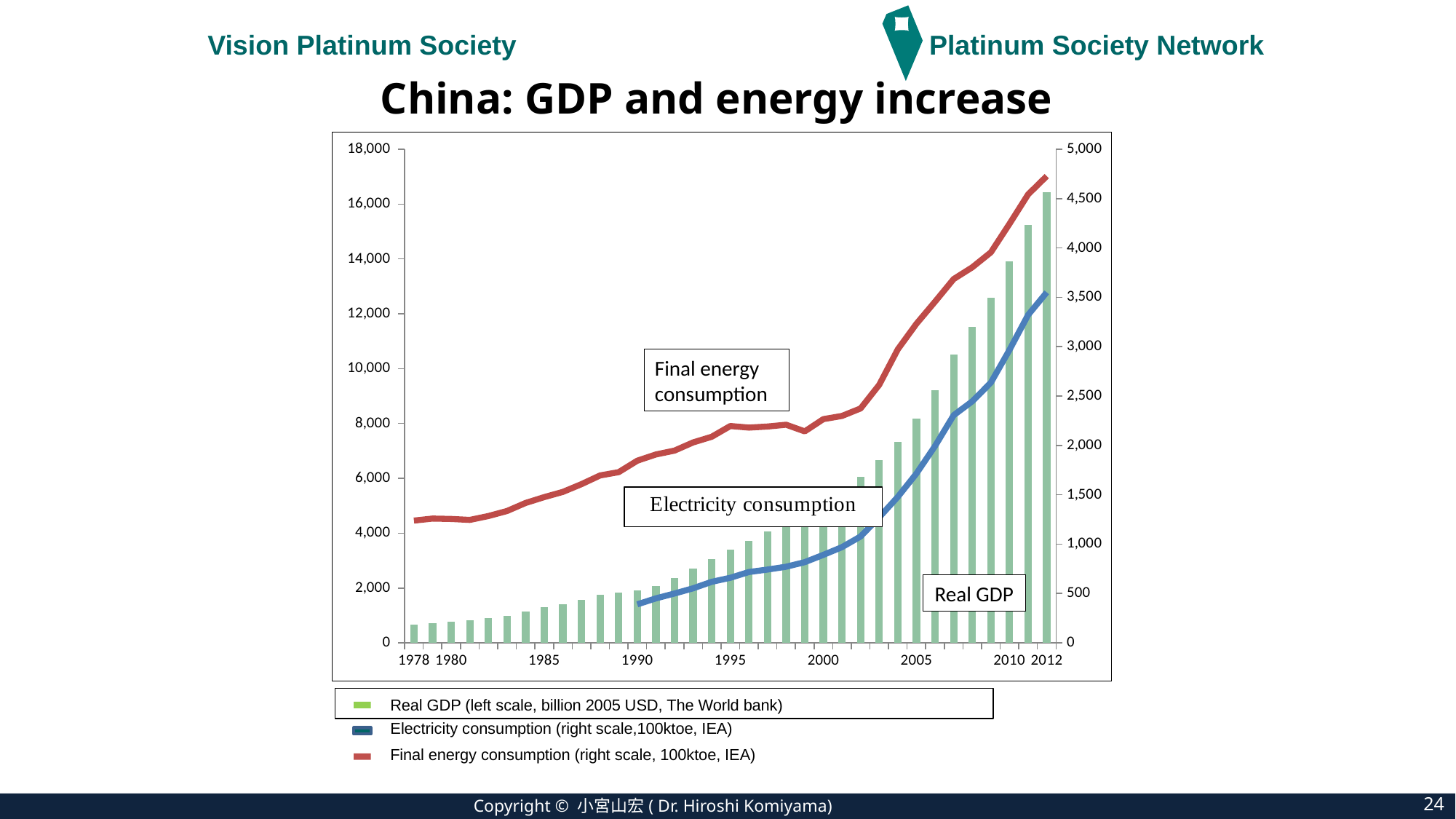
In which year is Real GDP lowest? 1978 Which series is plotted as bars? Real GDP In which year is Real GDP highest? 2012 Is the Real GDP value for 1978 greater or less than 2,000 on the left scale? less What is the title of the chart? China: GDP and energy increase What kind of chart is shown on the slide? A combined bar and line chart Is the Electricity consumption value for 2000 greater or less than 1,000 on the right scale? less In 2012, which is larger on the right scale: Final energy consumption or Electricity consumption? Final energy consumption Does Real GDP rise or fall from 1978 to 2012? Rise How many series does the legend list? 3 Is the Final energy consumption value for 2012 greater or less than 4,500 on the right scale? greater